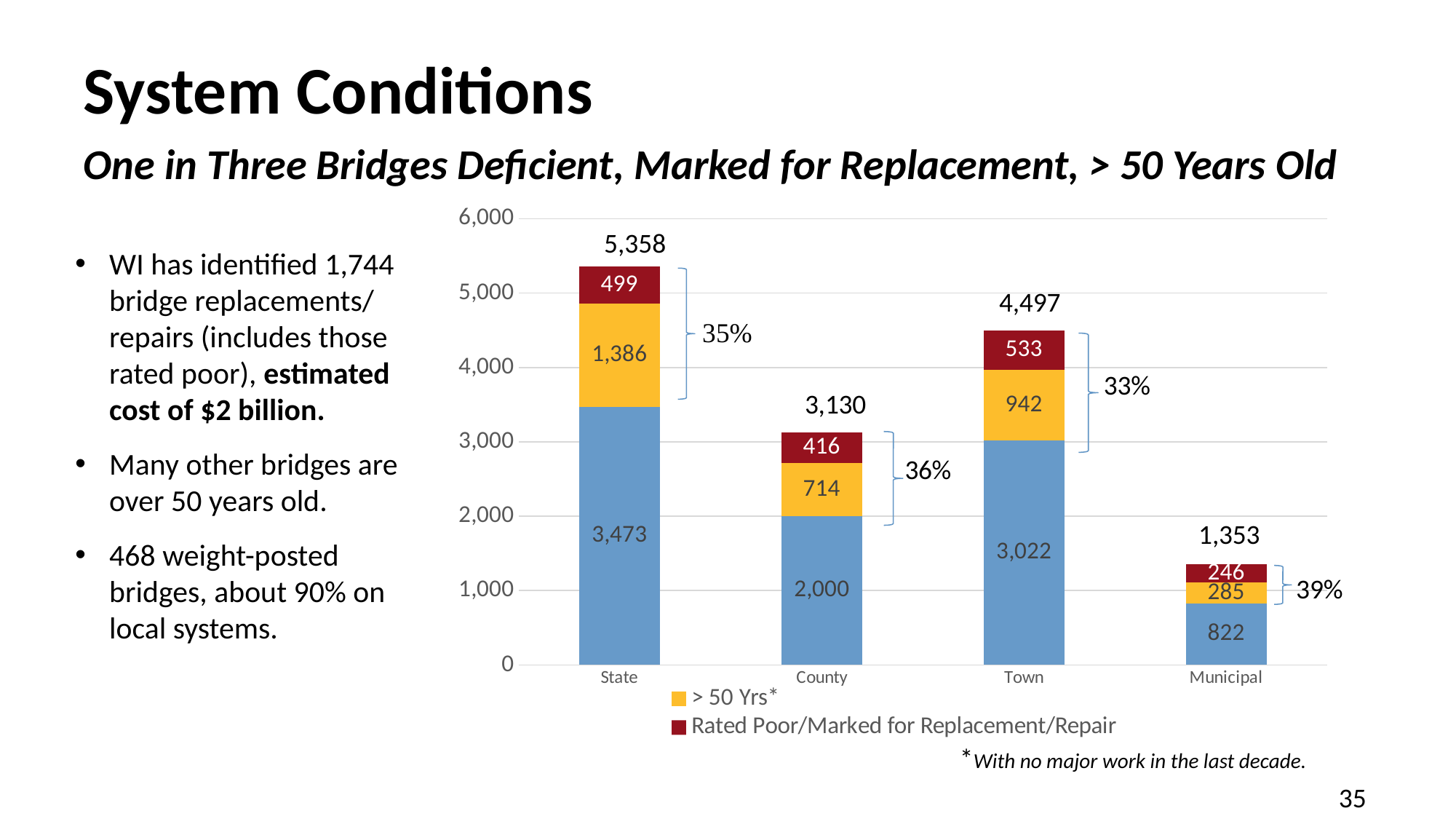
Which category has the lowest total bar? Municipal What is the difference between the 'Rated Poor/Marked for Replacement/Repair' values for Town and State? 34 What is the '> 50 Yrs*' value for Town? 942 What kind of chart is shown on the slide? Stacked bar chart What is the 'Rated Poor/Marked for Replacement/Repair' value for County? 416 What percentage is shown next to the bracket beside the Municipal bar? 39% Which category has the highest total bar? State How many categories are shown on the x axis of the chart? 4 Which is larger, the '> 50 Yrs*' value for State or for County? State What is the total value printed above the Municipal bar? 1,353 What is the total value printed above the State bar? 5,358 How many series does the chart's legend list? 2